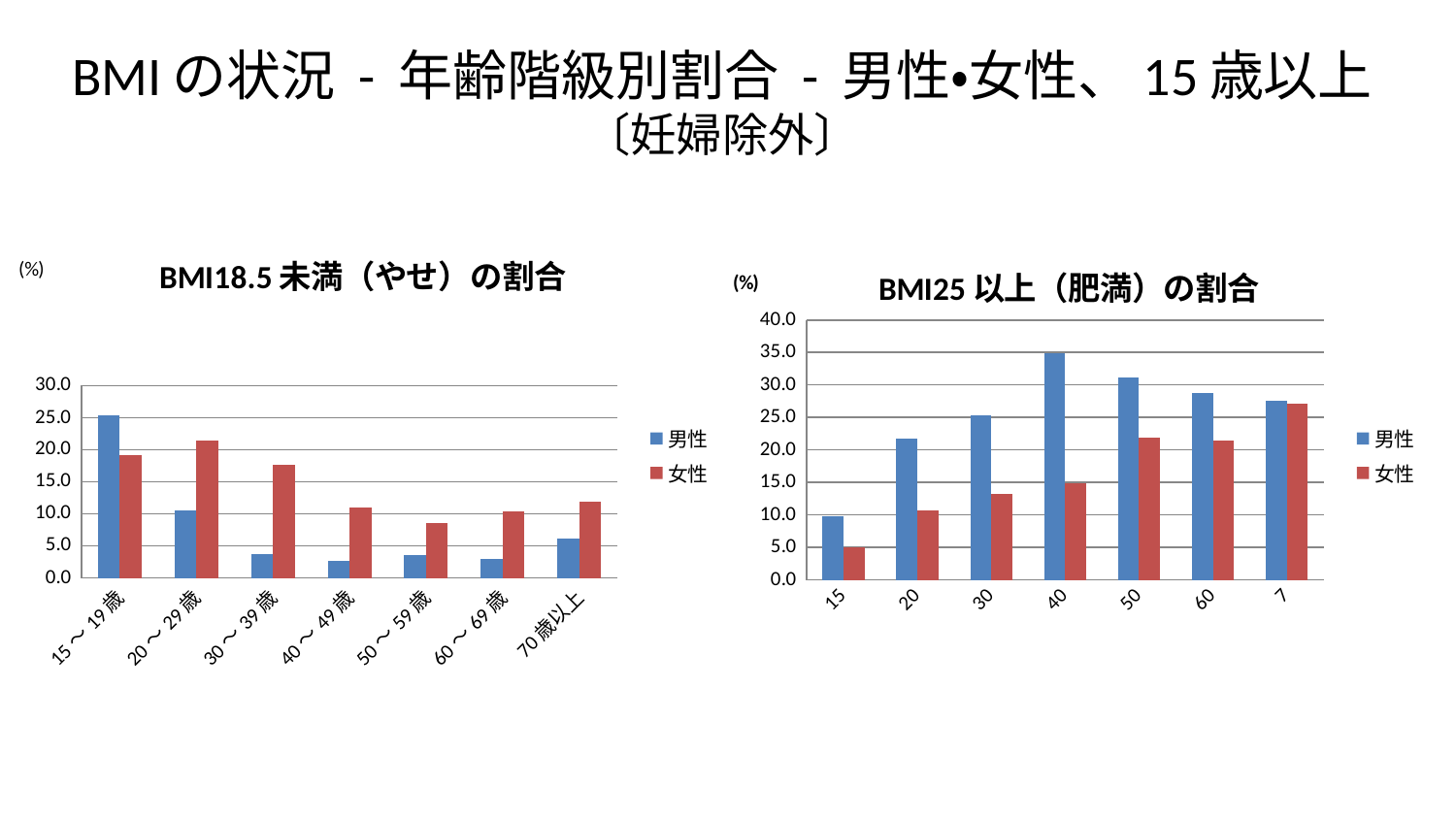
In the "BMI18.5未満（やせ）の割合" chart, which is larger at 20～29歳, 男性 or 女性? 女性 In the "BMI18.5未満（やせ）の割合" chart, which age group has the lowest value for 女性? 50～59歳 In the "BMI25以上（肥満）の割合" chart, is the value for 女性 at 15 greater or less than 10.0? less In the "BMI18.5未満（やせ）の割合" chart, which age group has the highest value for 女性? 20～29歳 In the "BMI18.5未満（やせ）の割合" chart, is the value for 男性 at 15～19歳 greater or less than 20.0? greater How many age categories are shown on the x axis of the "BMI18.5未満（やせ）の割合" chart? 7 What kind of chart is the "BMI18.5未満（やせ）の割合" chart on the left? bar chart How many series does the legend of the "BMI25以上（肥満）の割合" chart list? 2 In the "BMI25以上（肥満）の割合" chart, which is larger at 50, 男性 or 女性? 男性 In the "BMI18.5未満（やせ）の割合" chart, which age group has the highest value for 男性? 15～19歳 In the "BMI25以上（肥満）の割合" chart, which age category has the highest value for 男性? 40 In the "BMI25以上（肥満）の割合" chart, which age category has the lowest value for 女性? 15